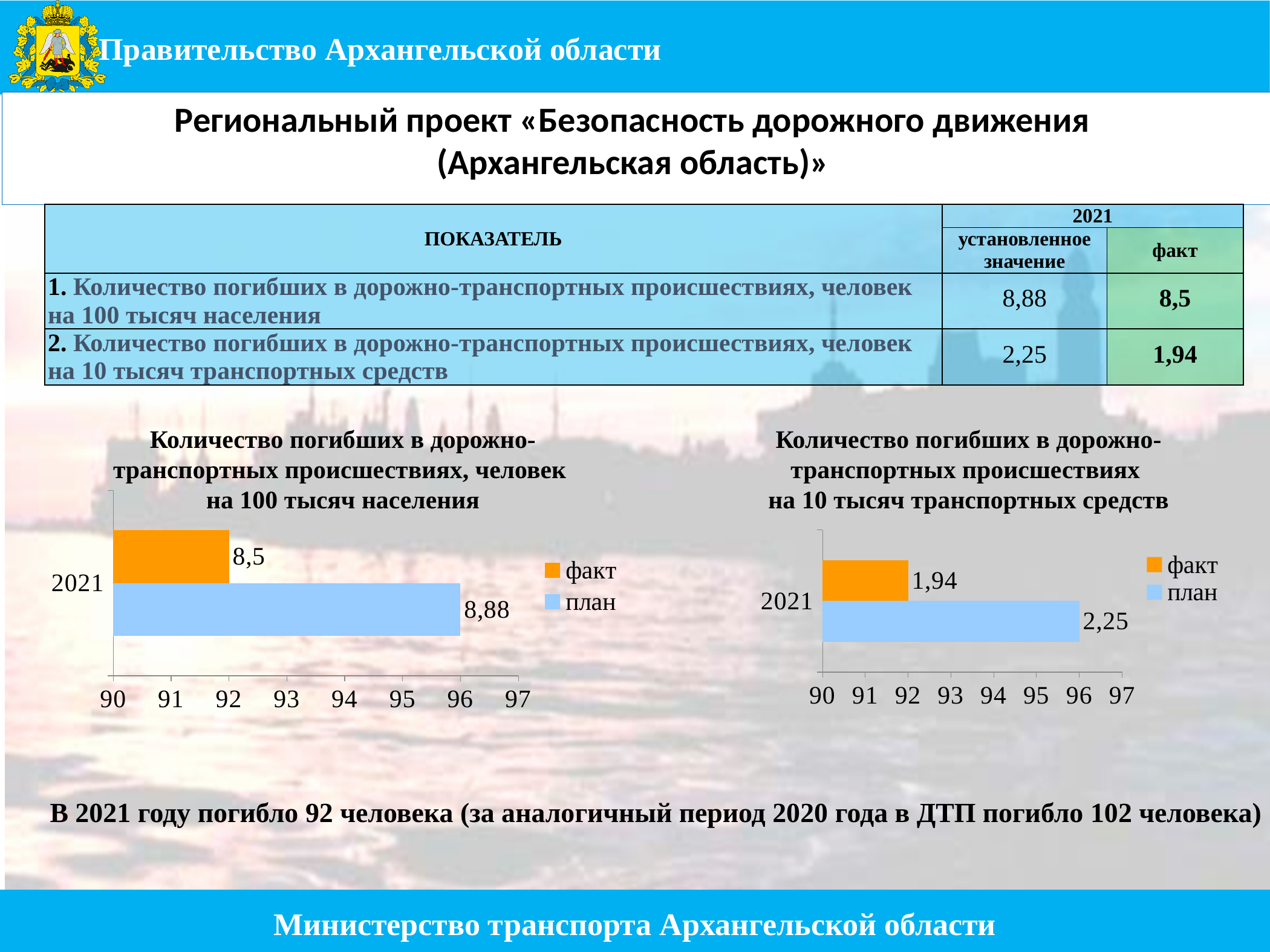
In the left chart (на 100 тысяч населения), what is the value of факт for 2021? 8,5 What type of chart is the right chart (на 10 тысяч транспортных средств)? bar chart In the right chart (на 10 тысяч транспортных средств), what is the value of факт for 2021? 1,94 In the right chart (на 10 тысяч транспортных средств), what is the value of план for 2021? 2,25 In the right chart (на 10 тысяч транспортных средств), which series has the smaller value for 2021, факт or план? факт In the left chart (на 100 тысяч населения), what is the value of план for 2021? 8,88 In the left chart (на 100 тысяч населения), which series has the larger value for 2021, факт or план? план In the left chart (на 100 тысяч населения), what is the difference between план and факт for 2021? 0,38 How many series does the legend of the left chart list? 2 In the right chart, which colour represents the факт series? orange In the right chart (на 10 тысяч транспортных средств), what is the difference between план and факт for 2021? 0,31 How many categories are shown on the y axis of the left chart? 1